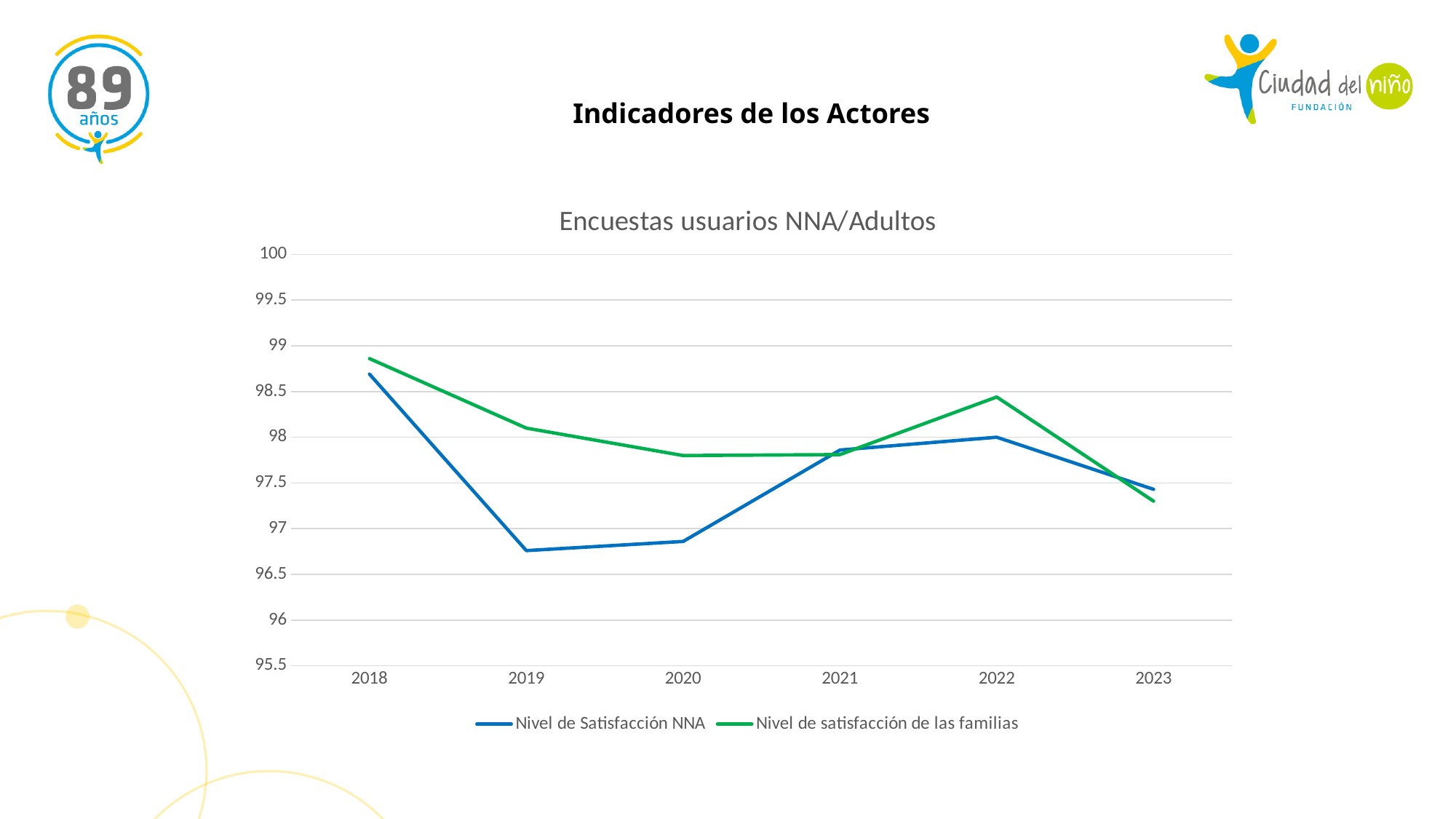
Is the value for Nivel de Satisfacción NNA in 2019 greater or less than 97? less Is the value for Nivel de satisfacción de las familias in 2022 greater or less than 98? greater In 2022, which series has the higher value, Nivel de Satisfacción NNA or Nivel de satisfacción de las familias? Nivel de satisfacción de las familias In which year is the Nivel de Satisfacción NNA line at its highest? 2018 How many series does the legend list? 2 In which year is the Nivel de satisfacción de las familias line at its lowest? 2023 In 2019, which series has the higher value, Nivel de Satisfacción NNA or Nivel de satisfacción de las familias? Nivel de satisfacción de las familias In which year is the Nivel de satisfacción de las familias line at its highest? 2018 How many years are plotted along the x axis? 6 What kind of chart is shown on the slide? line chart Does the Nivel de Satisfacción NNA line rise or fall from 2018 to 2019? fall What is the title of the chart? Encuestas usuarios NNA/Adultos